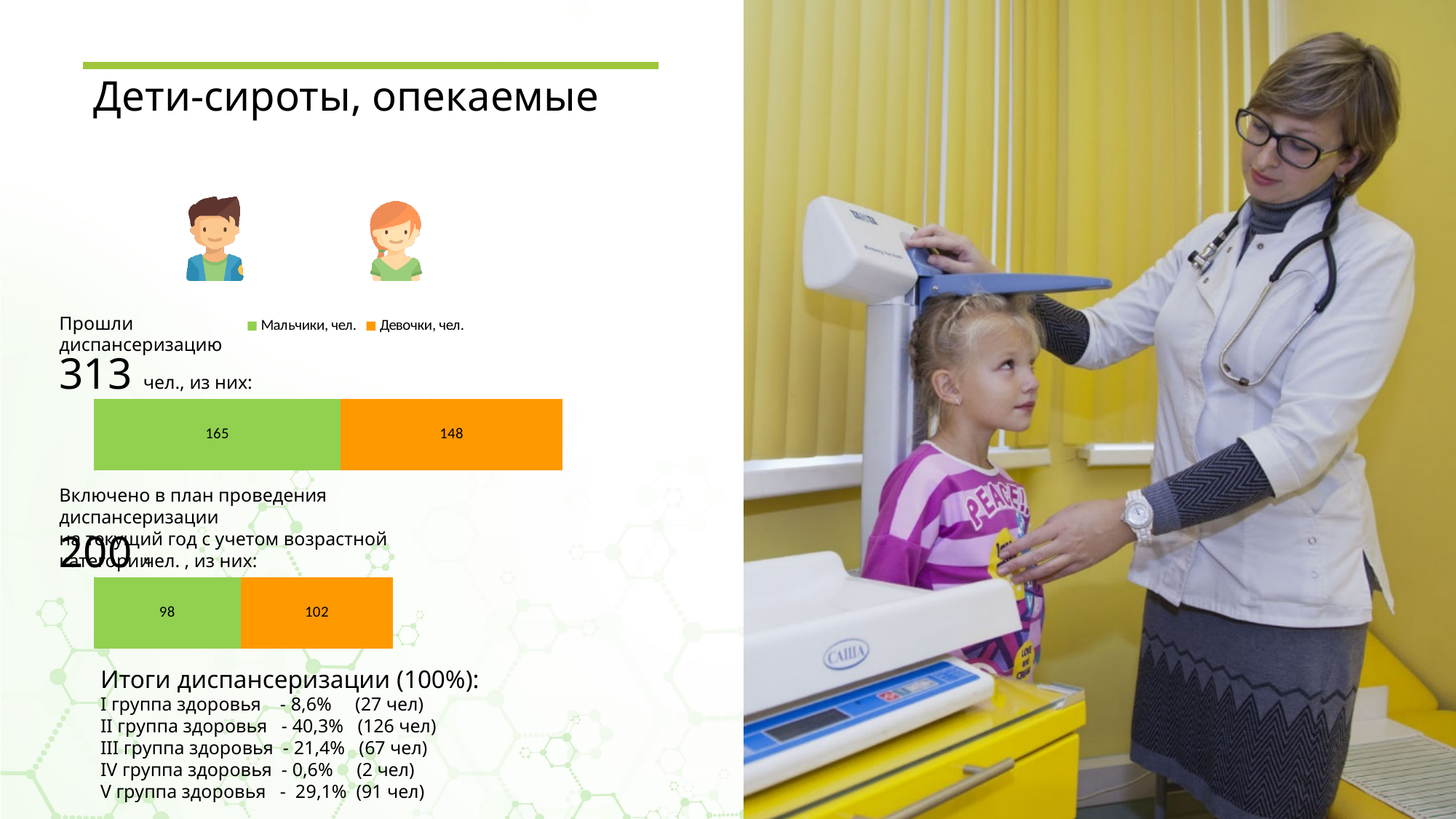
In the lower bar chart (Включено в план проведения диспансеризации), what is the value for Девочки, чел.? 102 In the lower bar chart, what is the difference between the Девочки and Мальчики values? 4 In the lower bar chart (Включено в план проведения диспансеризации), what is the value for Мальчики, чел.? 98 In the upper bar chart (Прошли диспансеризацию), what is the value for Девочки, чел.? 148 What type of chart is used to show the Мальчики and Девочки values on this slide? Stacked bar chart What is the total of the stacked bar in the lower chart? 200 In the upper bar chart (Прошли диспансеризацию), what is the value for Мальчики, чел.? 165 How many series does the legend above the upper chart list? 2 In the lower bar chart, which series has the larger value, Мальчики or Девочки? Девочки What is the total of the stacked bar in the upper chart? 313 In the upper bar chart, what is the difference between the Мальчики and Девочки values? 17 In the upper bar chart, which series has the larger value, Мальчики or Девочки? Мальчики